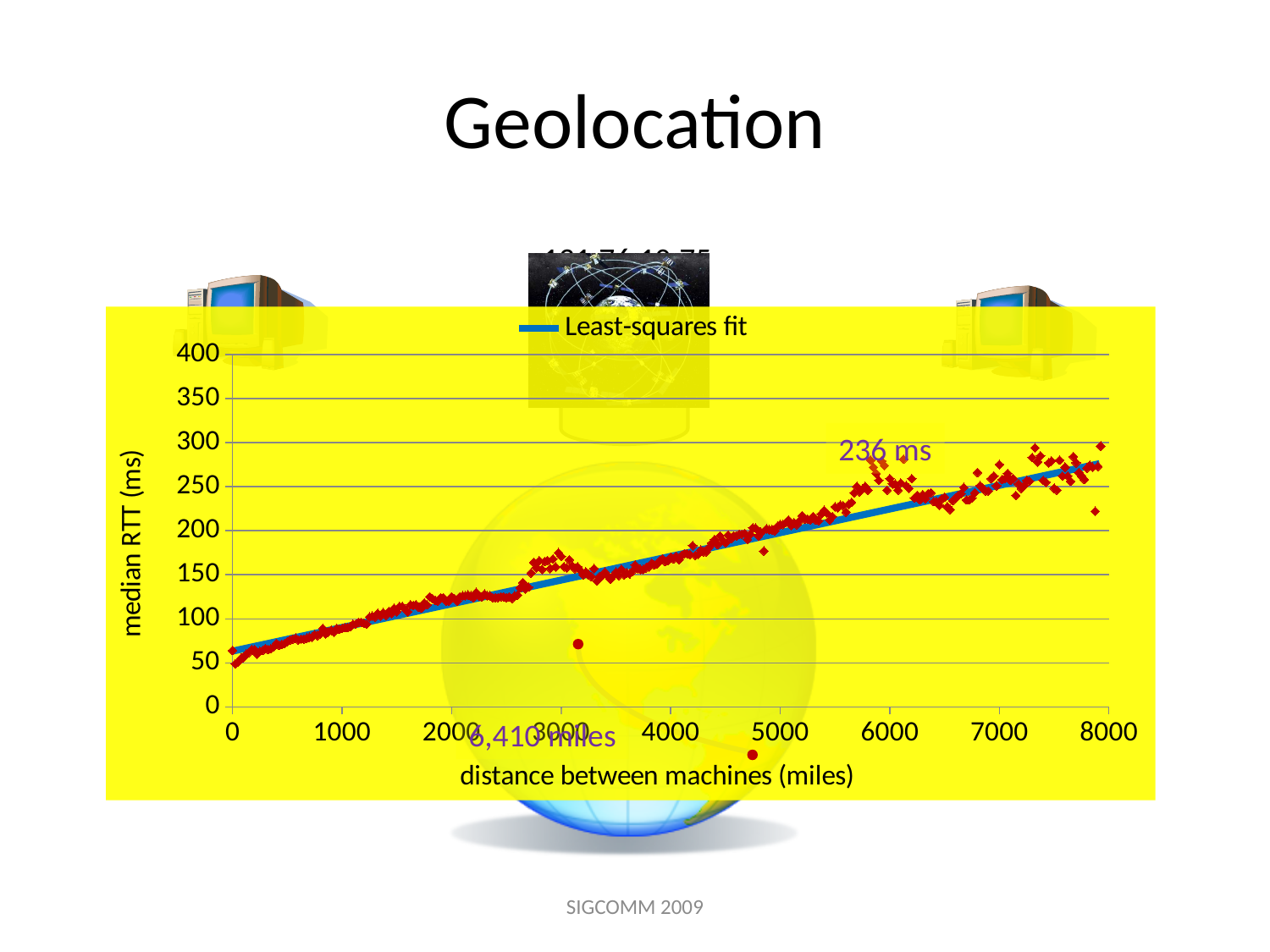
Is the median RTT at a distance of about 4000 miles greater or less than 200 ms? less Does the median RTT rise or fall as the distance between machines increases? rises Is the median RTT at a distance of about 7000 miles greater or less than 200 ms? greater What distance value is annotated on the chart? 6,410 miles What RTT value is annotated on the chart? 236 ms What kind of chart is shown on the slide? scatter chart What is the label of the y axis of the chart? median RTT (ms) What is the maximum value shown on the y axis? 400 What is the label of the x axis of the chart? distance between machines (miles) Which is larger, the median RTT at about 1000 miles or at about 6000 miles? about 6000 miles Is the median RTT at a distance of 0 miles greater or less than 100 ms? less What entry does the chart's legend list? Least-squares fit